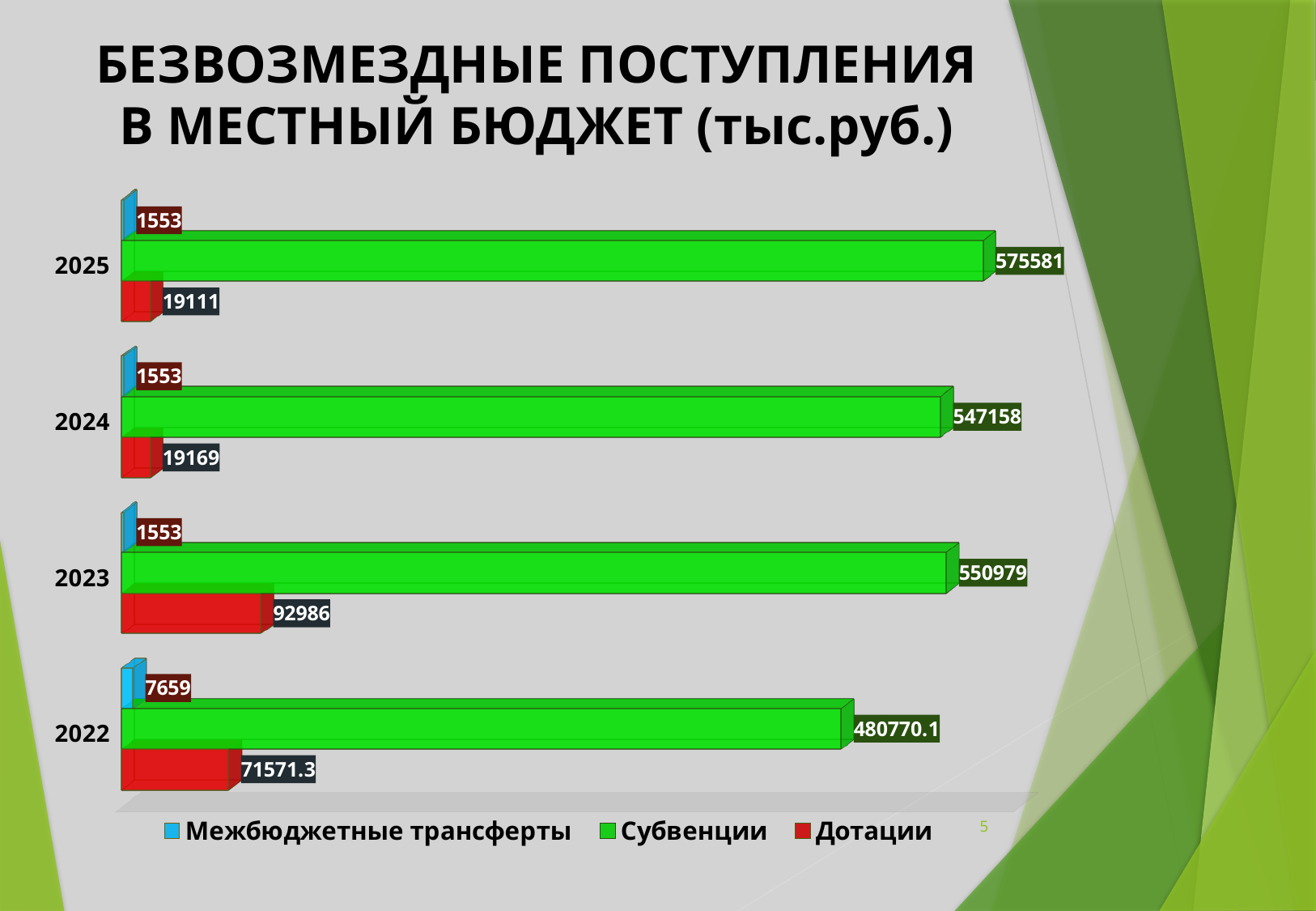
Which colour represents Субвенции in the chart? Green What is the value of Дотации for 2023? 92986 What is the value of Субвенции for 2022? 480770.1 In which year is the value of Субвенции the highest? 2025 What is the value of Межбюджетные трансферты for 2022? 7659 What is the difference between the Субвенции values for 2025 and 2024? 28423 Which is larger: Дотации for 2023 or Дотации for 2022? Дотации for 2023 How many years are shown on the chart? 4 In which year is the value of Дотации the lowest? 2025 How many series does the legend list? 3 What kind of chart is shown on the slide? Bar chart What is the value of Субвенции for 2025? 575581